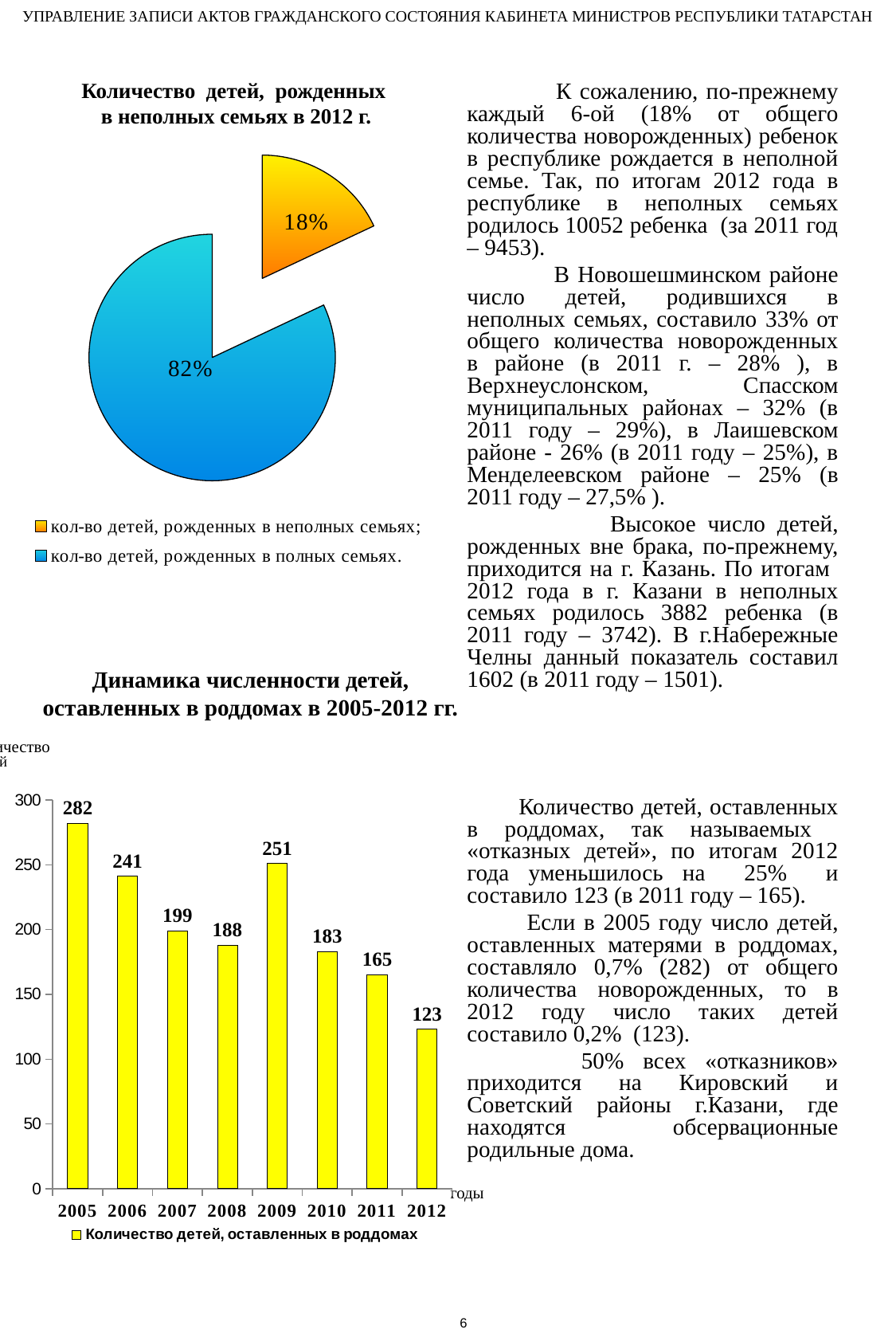
What type of chart is the bottom chart titled 'Динамика численности детей, оставленных в роддомах в 2005-2012 гг.'? bar chart In the pie chart 'Количество детей, рожденных в неполных семьях в 2012 г.', what share is shown for children born in two-parent families (полных семьях)? 82% How many entries does the legend of the pie chart 'Количество детей, рожденных в неполных семьях в 2012 г.' list? 2 In the bar chart 'Динамика численности детей, оставленных в роддомах в 2005-2012 гг.', what is the difference between the values for 2011 and 2012? 42 What type of chart is the top chart titled 'Количество детей, рожденных в неполных семьях в 2012 г.'? pie chart How many years (bars) are shown in the bar chart 'Динамика численности детей, оставленных в роддомах в 2005-2012 гг.'? 8 In the pie chart 'Количество детей, рожденных в неполных семьях в 2012 г.', what share is shown for children born in single-parent families (неполных семьях)? 18% In the bar chart 'Динамика численности детей, оставленных в роддомах в 2005-2012 гг.', what is the value for 2009? 251 In the bar chart 'Динамика численности детей, оставленных в роддомах в 2005-2012 гг.', what is the value for 2012? 123 In the bar chart 'Динамика численности детей, оставленных в роддомах в 2005-2012 гг.', which year has the highest value? 2005 In the bar chart 'Динамика численности детей, оставленных в роддомах в 2005-2012 гг.', which is larger: the value for 2007 or the value for 2008? 2007 In the bar chart 'Динамика численности детей, оставленных в роддомах в 2005-2012 гг.', which year has the lowest value? 2012